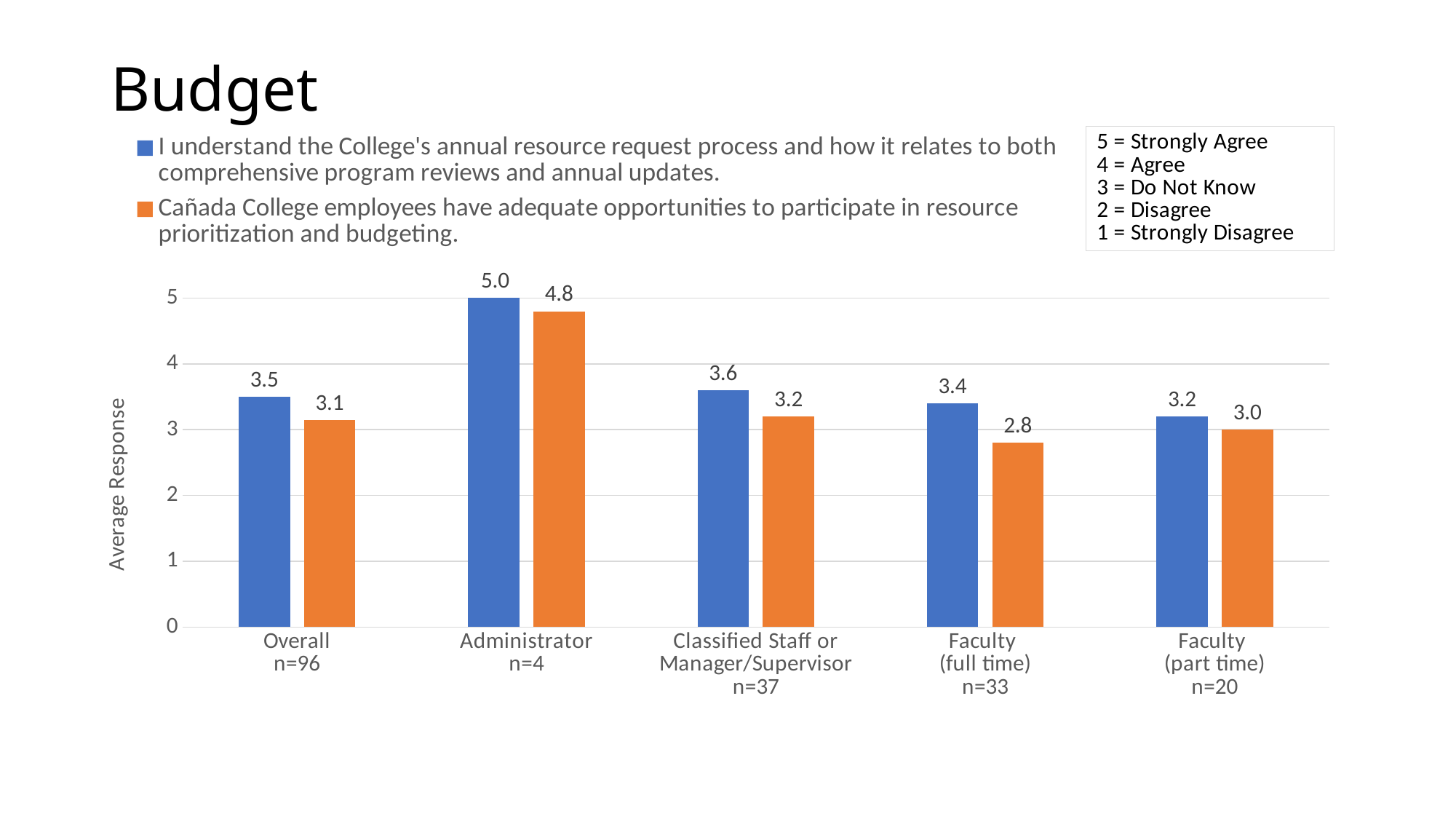
What is the difference between the Overall average responses for the two statements? 0.4 Which group has the lowest average response for the statement about adequate opportunities to participate in resource prioritization and budgeting? Faculty (full time) What is the difference between the two average responses for Administrator? 0.2 What is the label of the vertical axis? Average Response How many series does the legend list? 2 What kind of chart is shown on the slide? Bar chart What is the Overall average response for the statement about adequate opportunities to participate in resource prioritization and budgeting? 3.1 How many respondent groups are shown on the x axis? 5 What is the average response for Faculty (full time) on the statement 'Cañada College employees have adequate opportunities to participate in resource prioritization and budgeting.'? 2.8 What is the average response for Administrator on the statement 'I understand the College's annual resource request process and how it relates to both comprehensive program reviews and annual updates.'? 5.0 For Classified Staff or Manager/Supervisor, which statement has the higher average response: the one about understanding the resource request process or the one about adequate opportunities to participate? I understand the College's annual resource request process Which group has the highest average response for the statement 'I understand the College's annual resource request process...'? Administrator